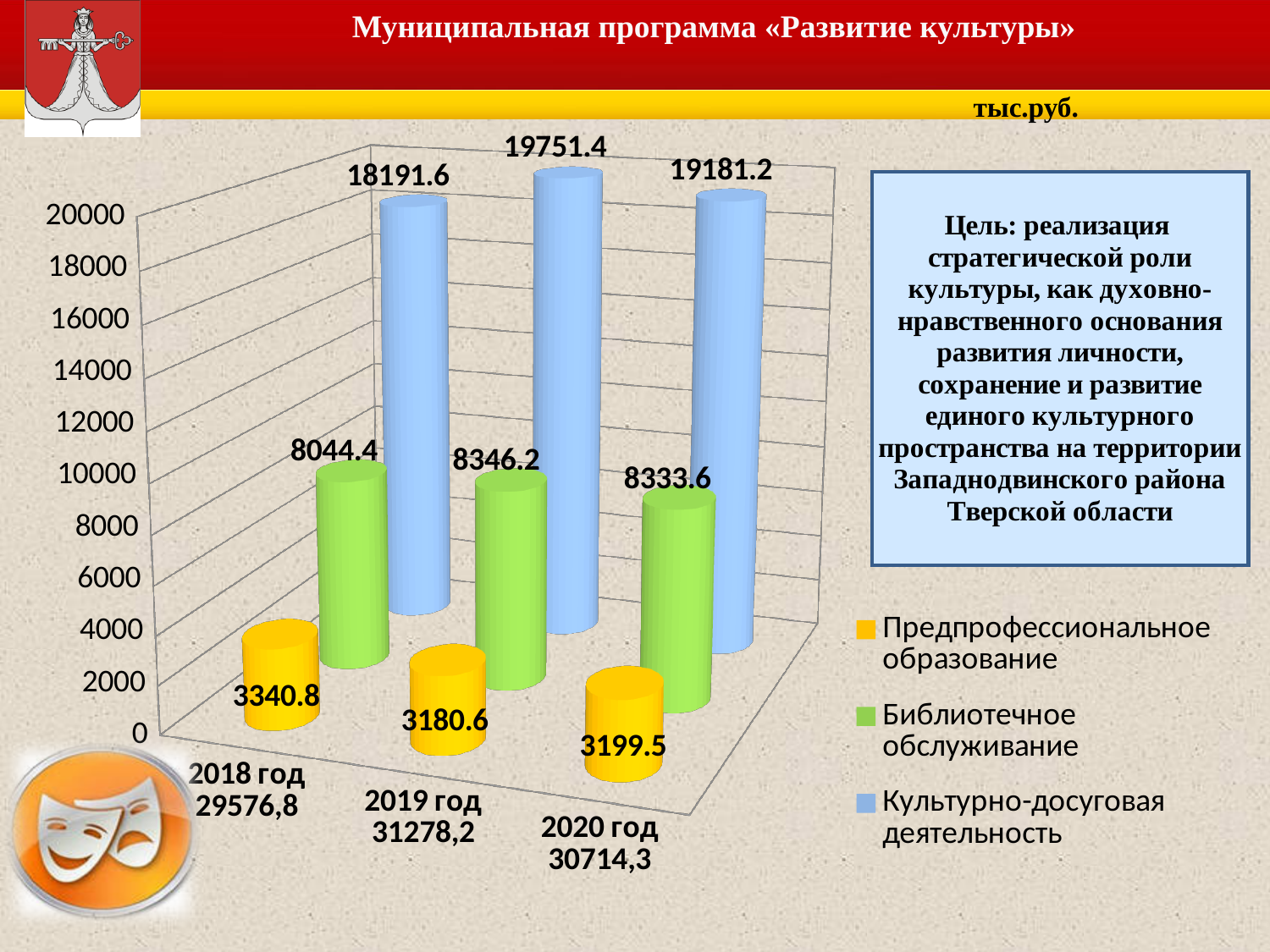
In which year is the value for Культурно-досуговая деятельность the highest? 2019 год How many series does the legend list? 3 What is the value for Культурно-досуговая деятельность in 2019 год? 19751.4 What is the difference between the Культурно-досуговая деятельность values for 2019 год and 2018 год? 1559.8 What kind of chart is shown on the slide? bar chart Is the value for Библиотечное обслуживание in 2020 год greater or less than 10000? less In which year is the value for Предпрофессиональное образование the lowest? 2019 год How many years are shown on the x axis of the chart? 3 What is the value for Предпрофессиональное образование in 2020 год? 3199.5 What is the value for Библиотечное обслуживание in 2018 год? 8044.4 Which is larger: the Культурно-досуговая деятельность value for 2018 год or for 2020 год? 2020 год What is the difference between the Предпрофессиональное образование values for 2018 год and 2019 год? 160.2